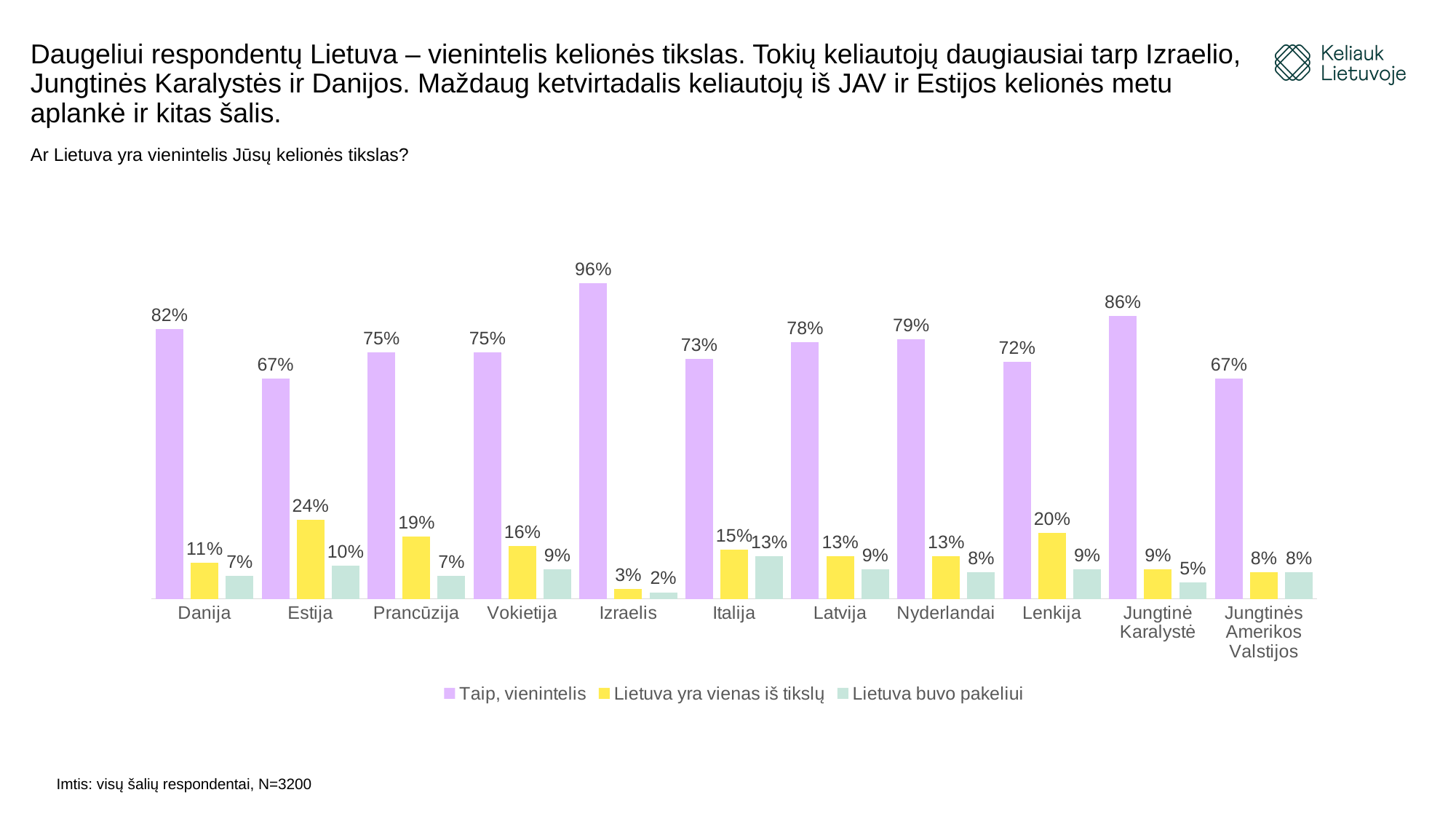
Which country has the lowest value for "Lietuva buvo pakeliui"? Izraelis What is the difference between the "Taip, vienintelis" values for Jungtinė Karalystė and Danija? 4% What is the value for "Lietuva buvo pakeliui" for Italija? 13% What is the value for "Taip, vienintelis" for Izraelis? 96% Which country has the highest value for "Taip, vienintelis"? Izraelis Which colour represents the "Taip, vienintelis" series? Purple What is the value for "Lietuva yra vienas iš tikslų" for Estija? 24% What is the total of the three values for Vokietija? 100% What kind of chart is shown on the slide? Bar chart How many countries are shown on the x axis? 11 Which is larger: the "Lietuva yra vienas iš tikslų" value for Lenkija or for Prancūzija? Lenkija How many series does the legend list? 3